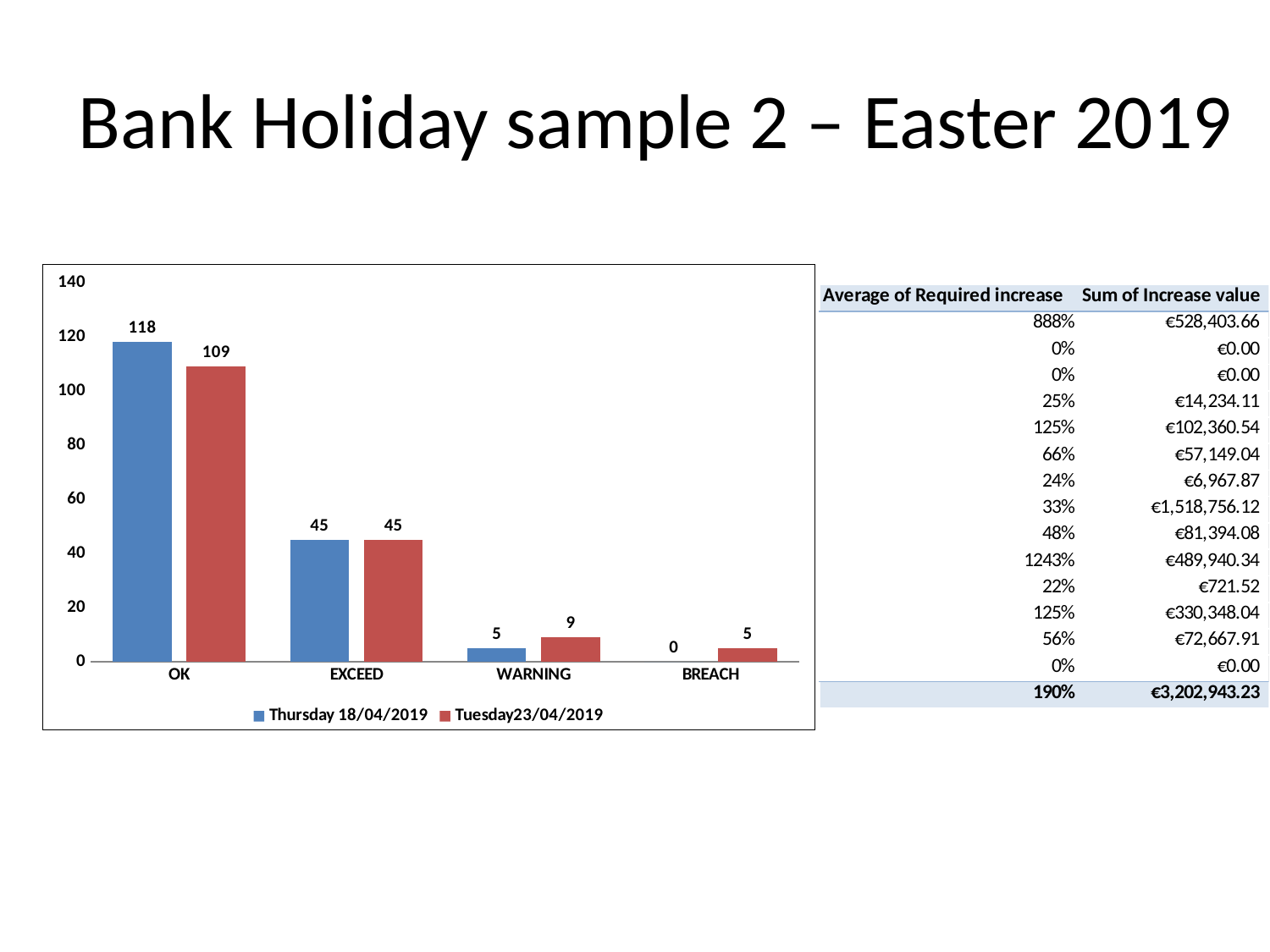
What kind of chart is shown on the slide? Bar chart Which is larger for WARNING: the Thursday 18/04/2019 value or the Tuesday23/04/2019 value? Tuesday23/04/2019 How many series does the chart legend list? 2 Which category has the highest value in the Thursday 18/04/2019 series? OK How many categories are shown on the x axis of the chart? 4 What is the difference between the Thursday 18/04/2019 and Tuesday23/04/2019 values for OK? 9 What is the value for OK in the Thursday 18/04/2019 series? 118 What is the value for WARNING in the Tuesday23/04/2019 series? 9 What is the value for BREACH in the Thursday 18/04/2019 series? 0 What is the value for OK in the Tuesday23/04/2019 series? 109 Which colour represents the Tuesday23/04/2019 series in the chart? Red Which category has the lowest value in the Tuesday23/04/2019 series? BREACH